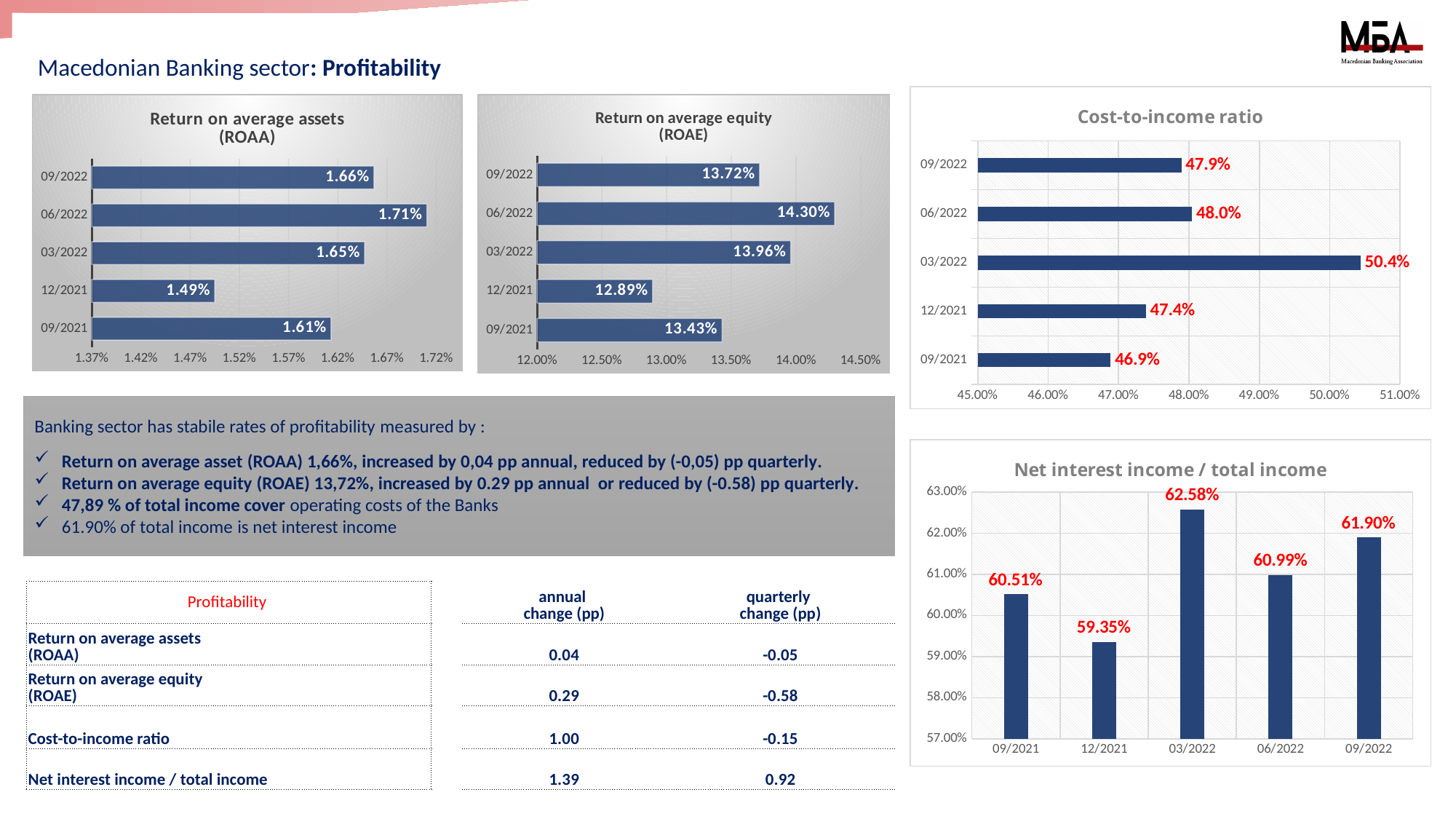
In the 'Return on average equity (ROAE)' chart, what is the difference between the 06/2022 and 12/2021 values? 1.41 pp In the 'Return on average assets (ROAA)' chart, which period has the lowest value? 12/2021 In the 'Return on average assets (ROAA)' chart, what is the value for 06/2022? 1.71% How many periods are shown in the 'Net interest income / total income' chart? 5 In the 'Net interest income / total income' chart, what is the value for 12/2021? 59.35% In the 'Net interest income / total income' chart, which is larger, the value for 03/2022 or 09/2022? 03/2022 In the 'Cost-to-income ratio' chart, is the value for 09/2022 greater or less than 48.00%? less In the 'Cost-to-income ratio' chart, which period has the lowest value? 09/2021 In the 'Return on average equity (ROAE)' chart, what is the value for 09/2022? 13.72% What type of chart is the 'Cost-to-income ratio' chart? Bar chart In the 'Return on average equity (ROAE)' chart, which period has the highest value? 06/2022 In the 'Cost-to-income ratio' chart, what is the value for 03/2022? 50.4%